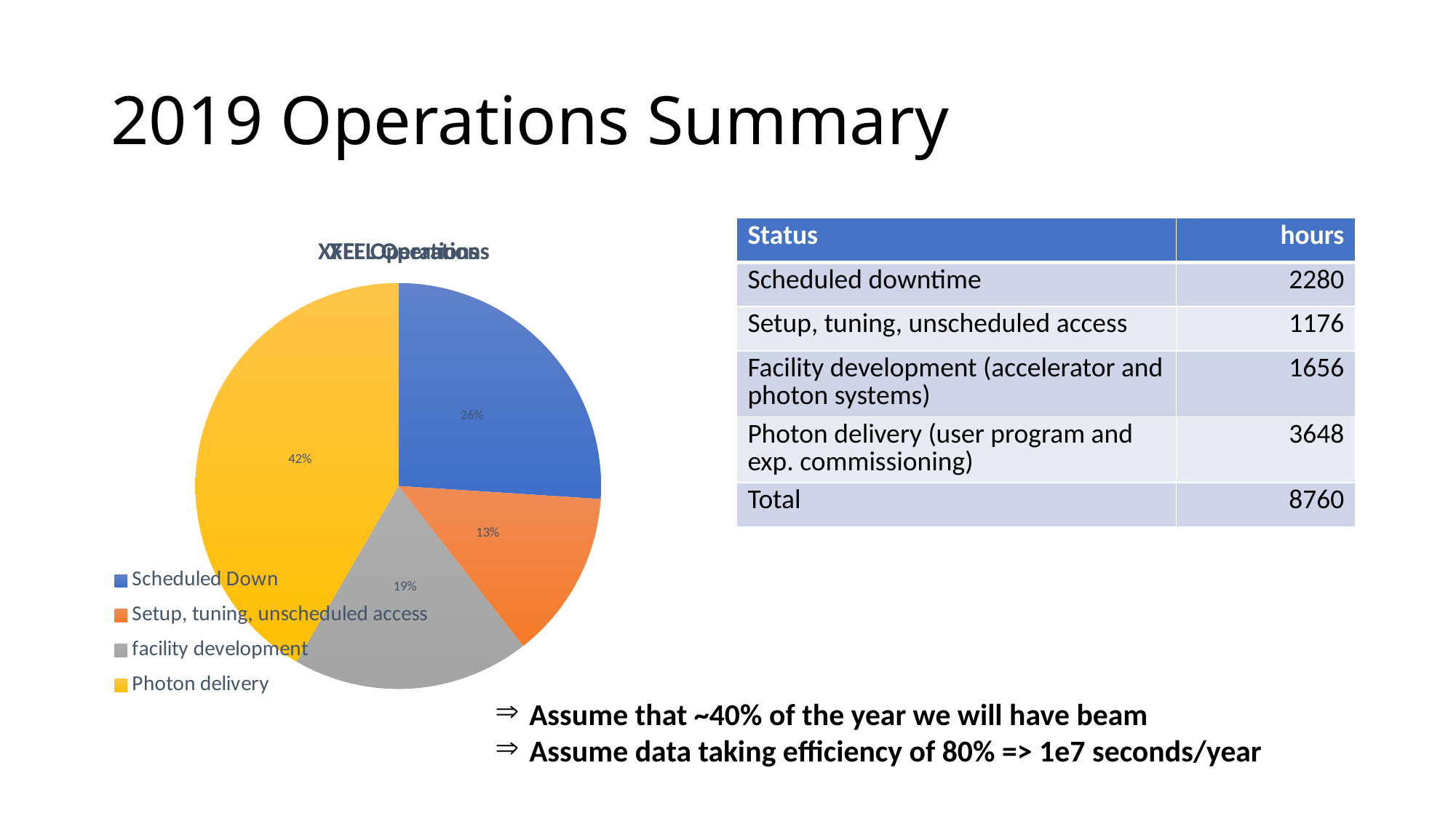
Which slice is larger in the pie chart, Scheduled Down or facility development? Scheduled Down What is the difference in percentage points between the Photon delivery slice and the Scheduled Down slice? 16 Which category has the largest slice of the pie chart? Photon delivery What percentage of the pie chart is facility development? 19% What percentage of the pie chart is Scheduled Down? 26% What colour is the Photon delivery slice in the pie chart? yellow What percentage of the pie chart is Photon delivery? 42% What kind of chart is shown on the slide? pie chart What percentage of the pie chart is Setup, tuning, unscheduled access? 13% How many entries does the pie chart legend list? 4 Which category has the smallest slice of the pie chart? Setup, tuning, unscheduled access How many slices does the pie chart have? 4